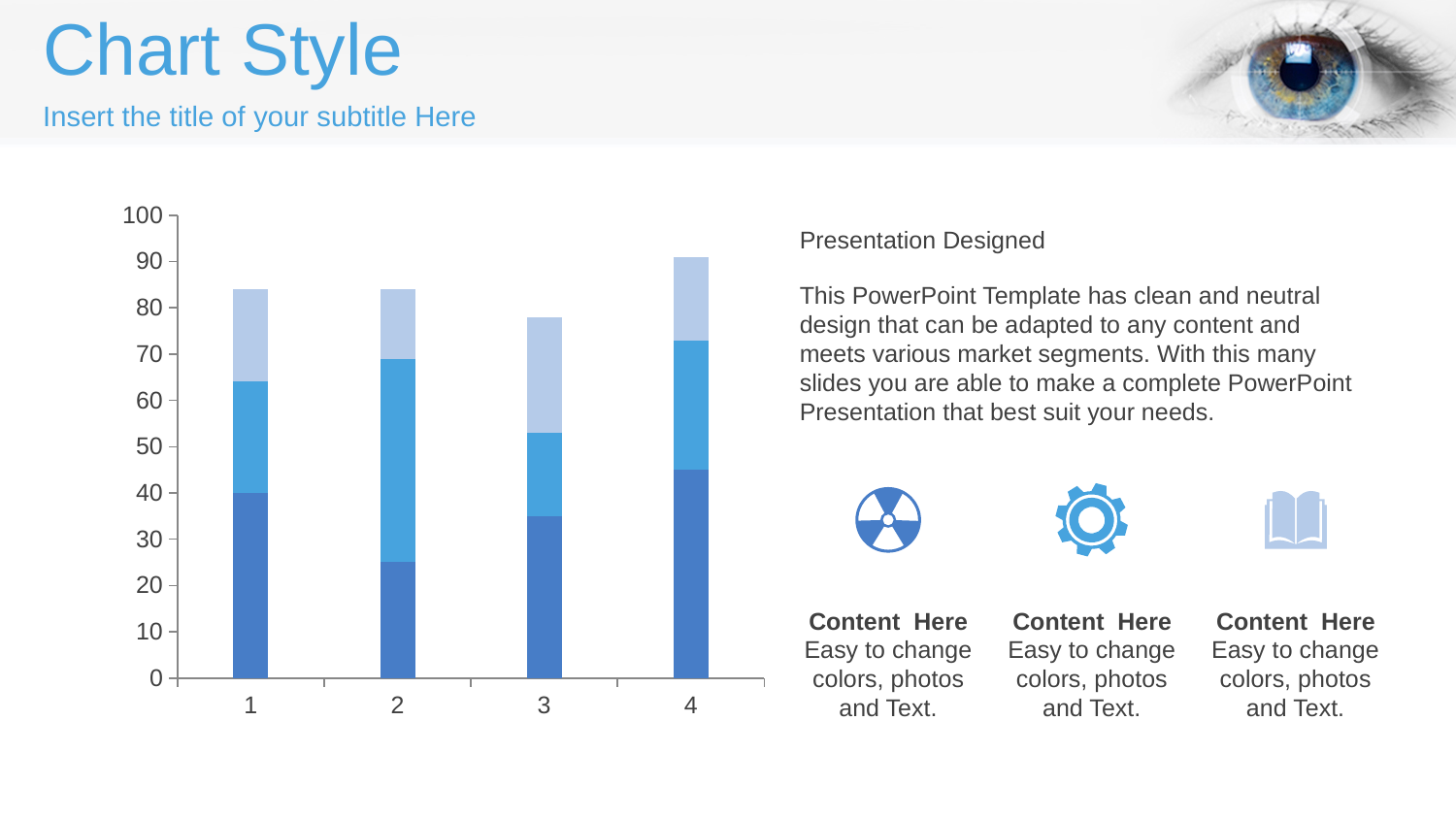
What kind of chart is shown on the slide? stacked bar chart Is the total height of the bar for category 4 greater or less than 80? greater Is the total height of the bar for category 3 greater or less than 80? less How many categories are shown on the x axis of the chart? 4 Is the bottom (dark blue) segment for category 2 greater or less than 30? less Which category has the tallest stacked bar overall? 4 What is the highest value shown on the y axis of the chart? 100 Which has the taller stacked bar overall, category 1 or category 3? 1 Which category has the largest bottom (dark blue) segment? 4 How many stacked segments does each bar in the chart have? 3 Which category has the shortest stacked bar overall? 3 Which category has the smallest bottom (dark blue) segment? 2